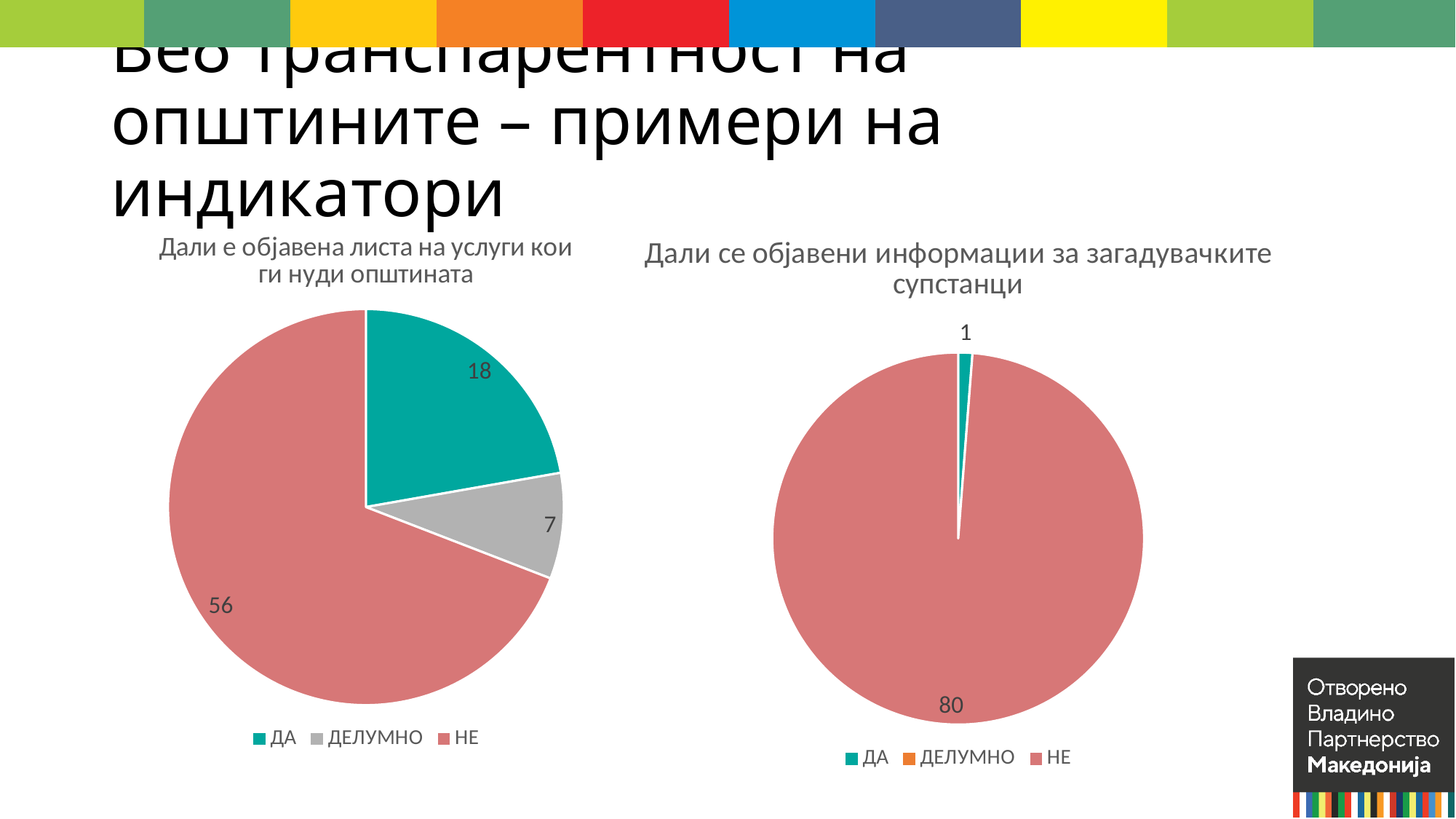
In the left pie chart (Дали е објавена листа на услуги кои ги нуди општината), what is the value for ДЕЛУМНО? 7 In the left pie chart (Дали е објавена листа на услуги кои ги нуди општината), which category has the smallest slice? ДЕЛУМНО In the left pie chart (Дали е објавена листа на услуги кои ги нуди општината), what is the value for НЕ? 56 In the left pie chart (Дали е објавена листа на услуги кои ги нуди општината), which category has the largest slice? НЕ How many entries does the legend of the right pie chart (Дали се објавени информации за загадувачките супстанци) list? 3 In the left pie chart (Дали е објавена листа на услуги кои ги нуди општината), what is the value for ДА? 18 In the left pie chart (Дали е објавена листа на услуги кои ги нуди општината), what is the difference between the values for НЕ and ДА? 38 In the left pie chart (Дали е објавена листа на услуги кои ги нуди општината), which is larger, ДА or ДЕЛУМНО? ДА What type of chart is used on the left of the slide? Pie chart In the right pie chart (Дали се објавени информации за загадувачките супстанци), what is the value for ДА? 1 In the right pie chart (Дали се објавени информации за загадувачките супстанци), what is the value for НЕ? 80 In the right pie chart (Дали се објавени информации за загадувачките супстанци), what is the difference between the values for НЕ and ДА? 79